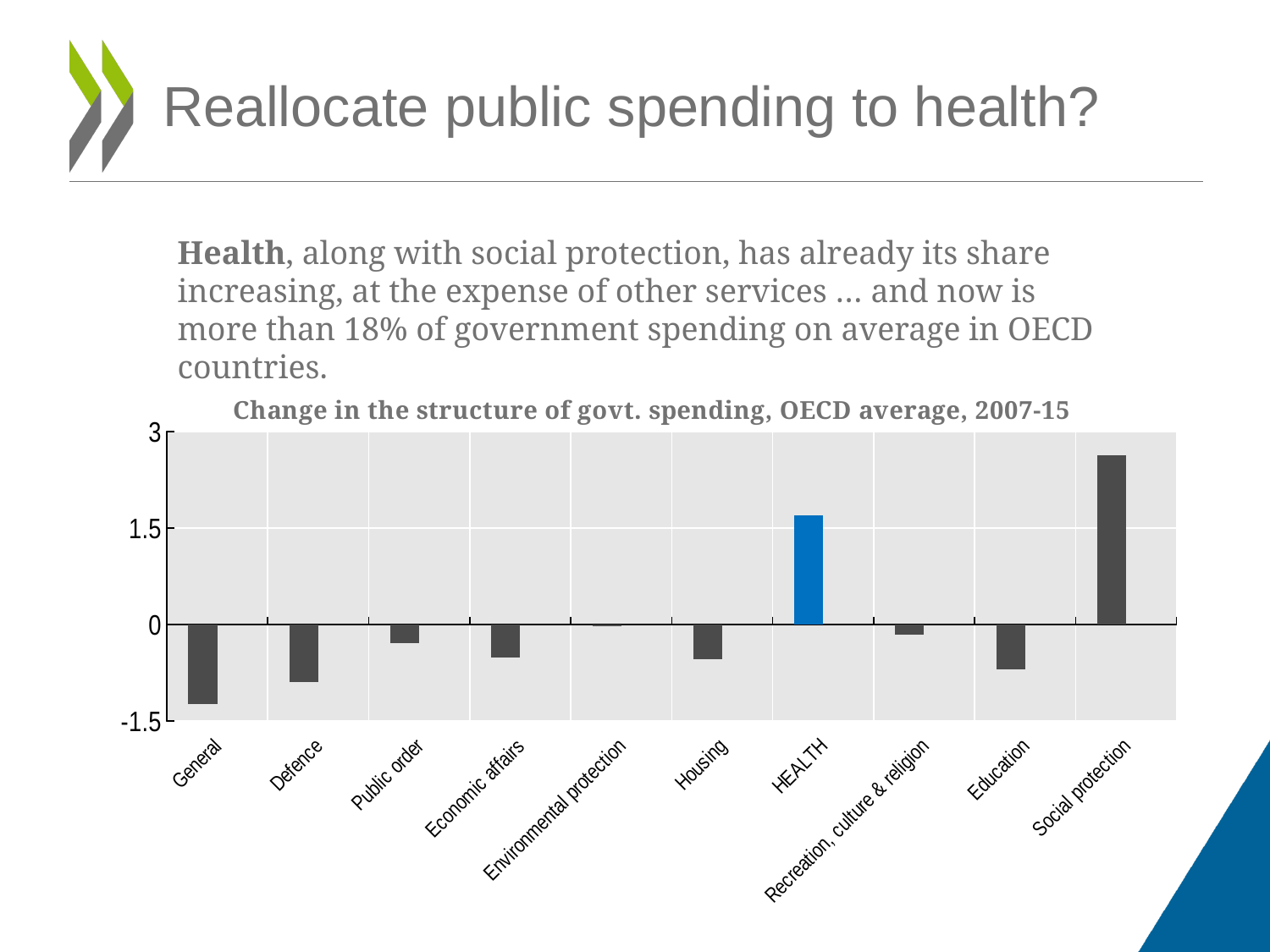
Is the value for HEALTH greater or less than 1.5? greater What is the title of the chart? Change in the structure of govt. spending, OECD average, 2007-15 What kind of chart is shown on the slide? Bar chart Which category has the lowest value in the chart? General Which category has the highest value in the chart? Social protection How many spending categories are shown on the x axis of the chart? 10 Is the value for Defence greater or less than -1.5? greater Is the value for Social protection greater or less than 1.5? greater Which is larger, the value for Public order or the value for General? Public order Which is larger, the value for Social protection or the value for HEALTH? Social protection Which bar in the chart is coloured blue rather than dark grey? HEALTH